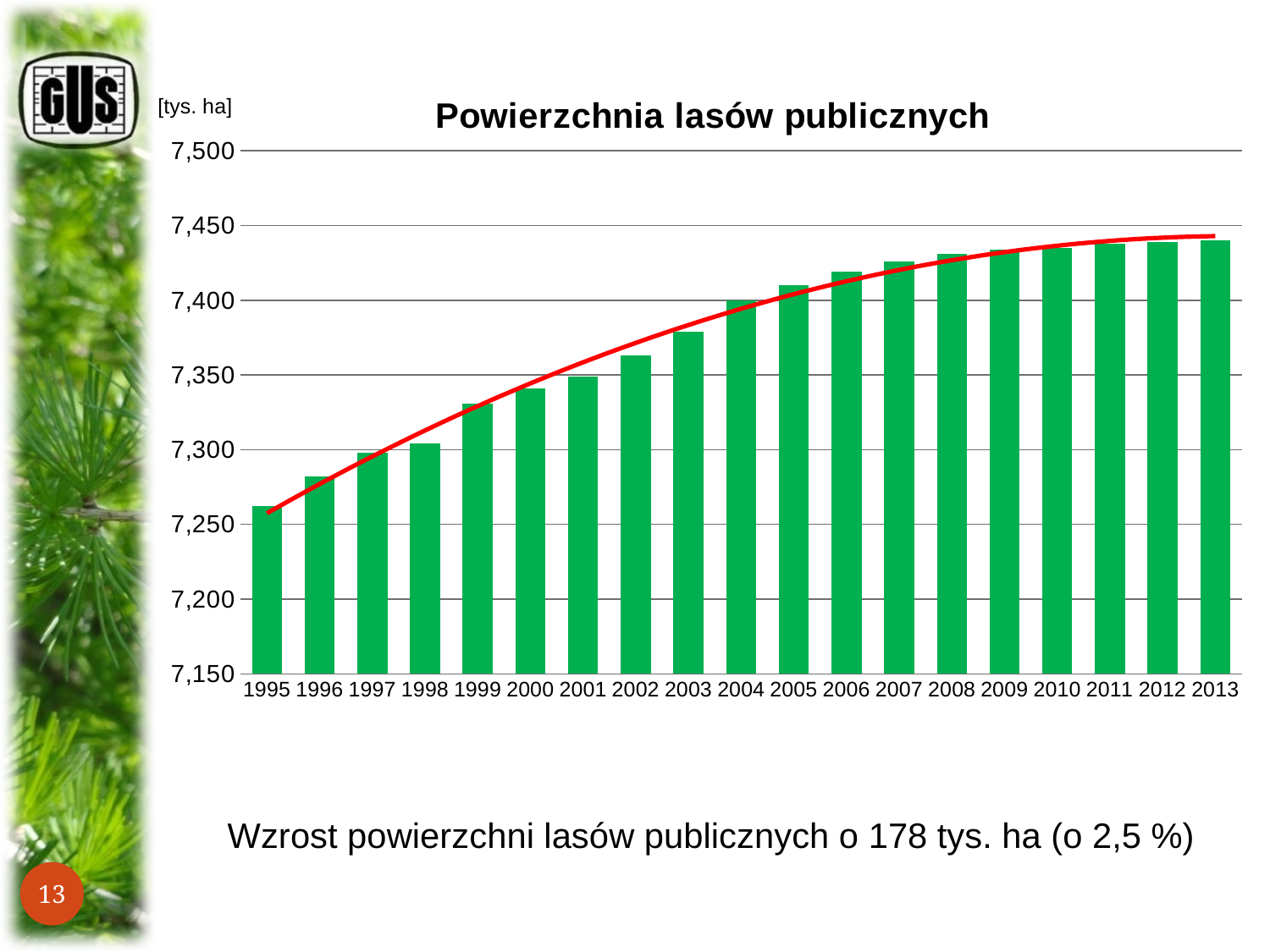
Is the value for 1995 greater or less than 7,250? greater Which is larger, the value for 2013 or the value for 1995? 2013 Do the values rise or fall from 1995 to 2013? rise Is the value for 2000 greater or less than 7,350? less Is the value for 2013 greater or less than 7,450? less What kind of chart is shown on the slide? bar chart Which year has the lowest value on the chart? 1995 Which year has the highest value on the chart? 2013 What is the title of the chart? Powierzchnia lasów publicznych What unit is shown for the values on the chart? tys. ha How many years (bars) are plotted on the chart? 19